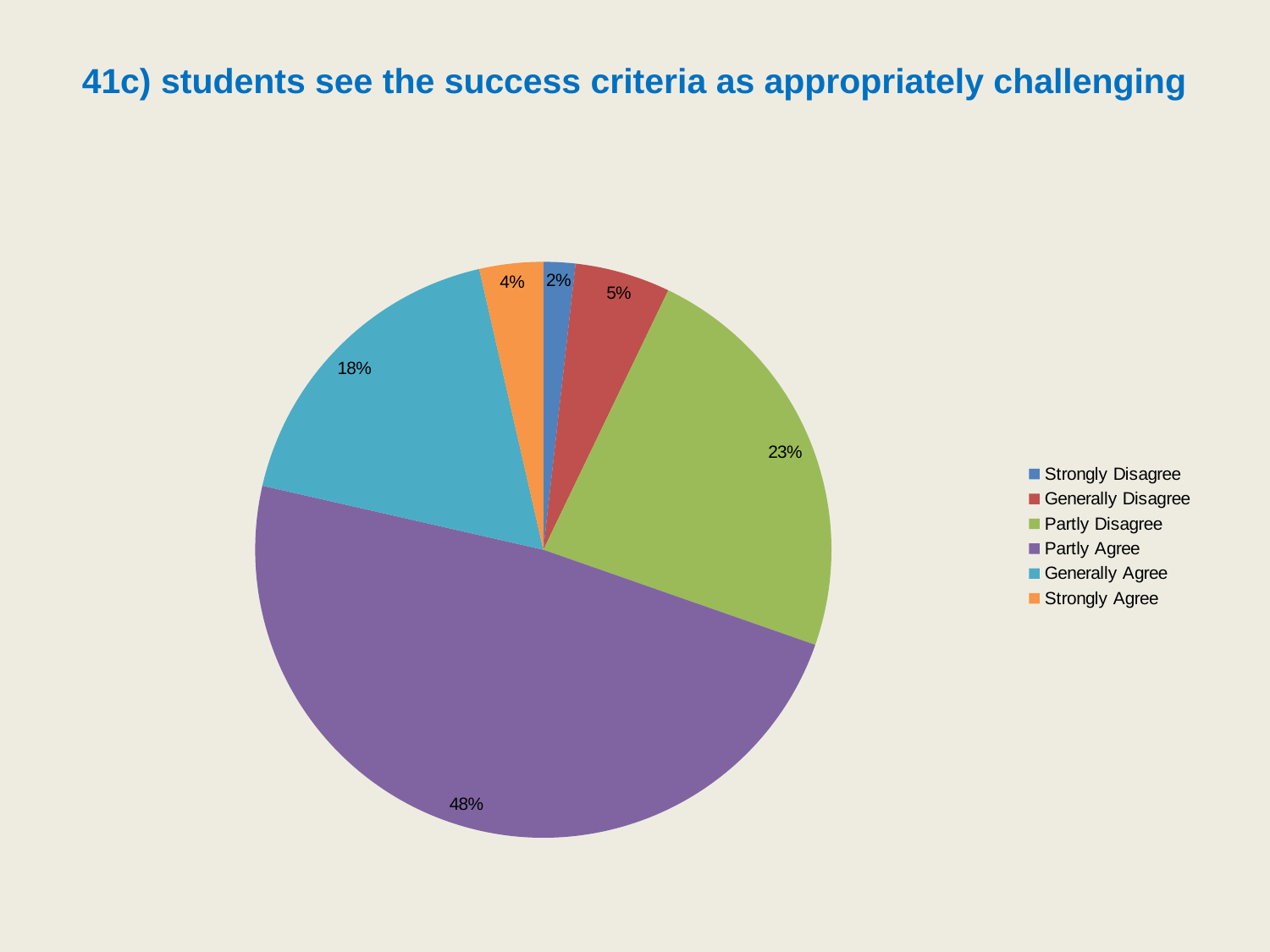
Which response category has the smallest share of the pie? Strongly Disagree How many response categories does the legend list? 6 Which response category has the largest share of the pie? Partly Agree What is the difference in percentage points between 'Partly Agree' and 'Partly Disagree'? 25 What is the title of the chart on the slide? 41c) students see the success criteria as appropriately challenging What percentage of students responded 'Generally Agree'? 18% What percentage of students responded 'Strongly Agree'? 4% What percentage of students responded 'Strongly Disagree'? 2% What kind of chart is shown on the slide? pie chart What percentage of students responded 'Partly Agree'? 48% Which is larger, the share for 'Generally Agree' or the share for 'Generally Disagree'? Generally Agree What percentage of students responded 'Partly Disagree'? 23%